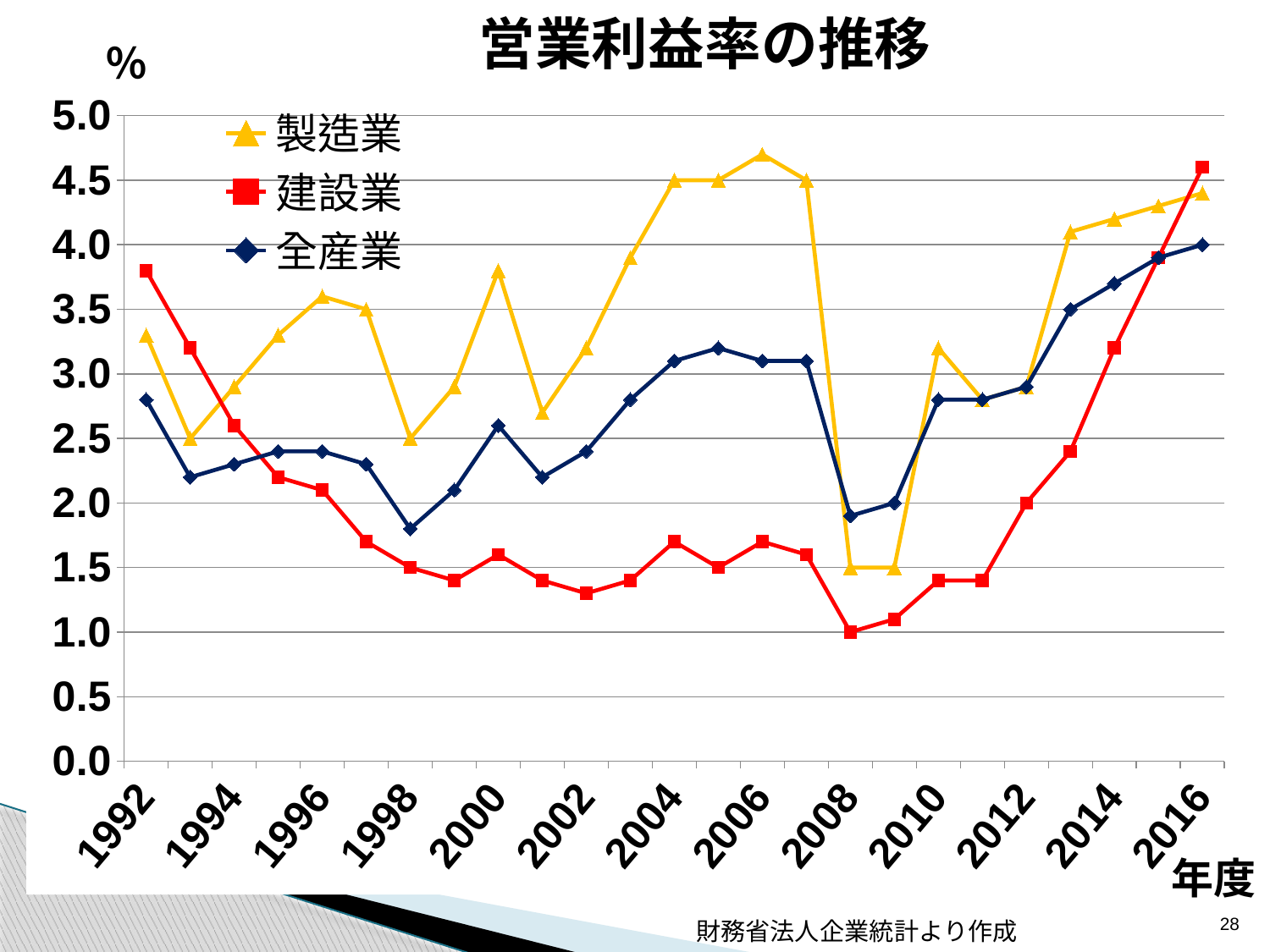
What is the value for 建設業 in 2008? 1.0 Which series is drawn in red with square markers? 建設業 What kind of chart is shown on the slide? line chart How many series does the legend list? 3 In which year does the 建設業 series reach its lowest value? 2008 Does the 建設業 series rise or fall from 2012 to 2016? rise In which year does the 製造業 series reach its highest value? 2006 Is the value for 製造業 in 2009 greater or less than 2.0? less What is the title of the chart? 営業利益率の推移 Is the value for 建設業 in 1992 greater or less than 3.5? greater Which series has the highest value in 2016? 建設業 In 2012, which is larger, the value for 製造業 or the value for 建設業? 製造業